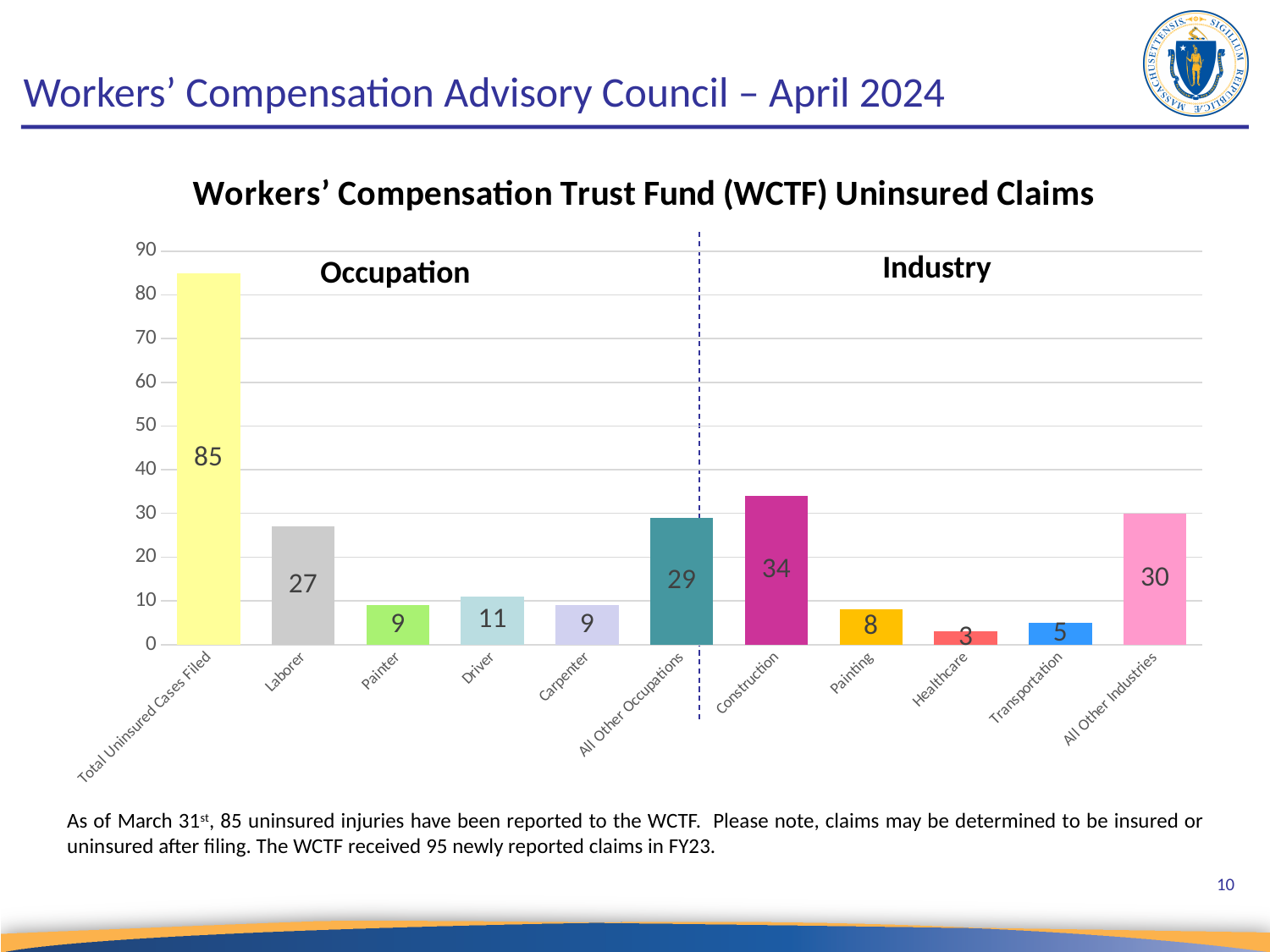
What is the title of the chart? Workers' Compensation Trust Fund (WCTF) Uninsured Claims What is the value for Total Uninsured Cases Filed? 85 Which is larger, the value for Driver or the value for Painter? Driver Which category has the lowest value? Healthcare What is the value for Construction? 34 Which category has the highest value? Total Uninsured Cases Filed How many categories are shown on the x axis? 11 What kind of chart is this? bar chart What is the value for Healthcare? 3 What is the difference between the values for Construction and All Other Industries? 4 Is the value for All Other Occupations greater or less than 20? greater What is the value for Laborer? 27